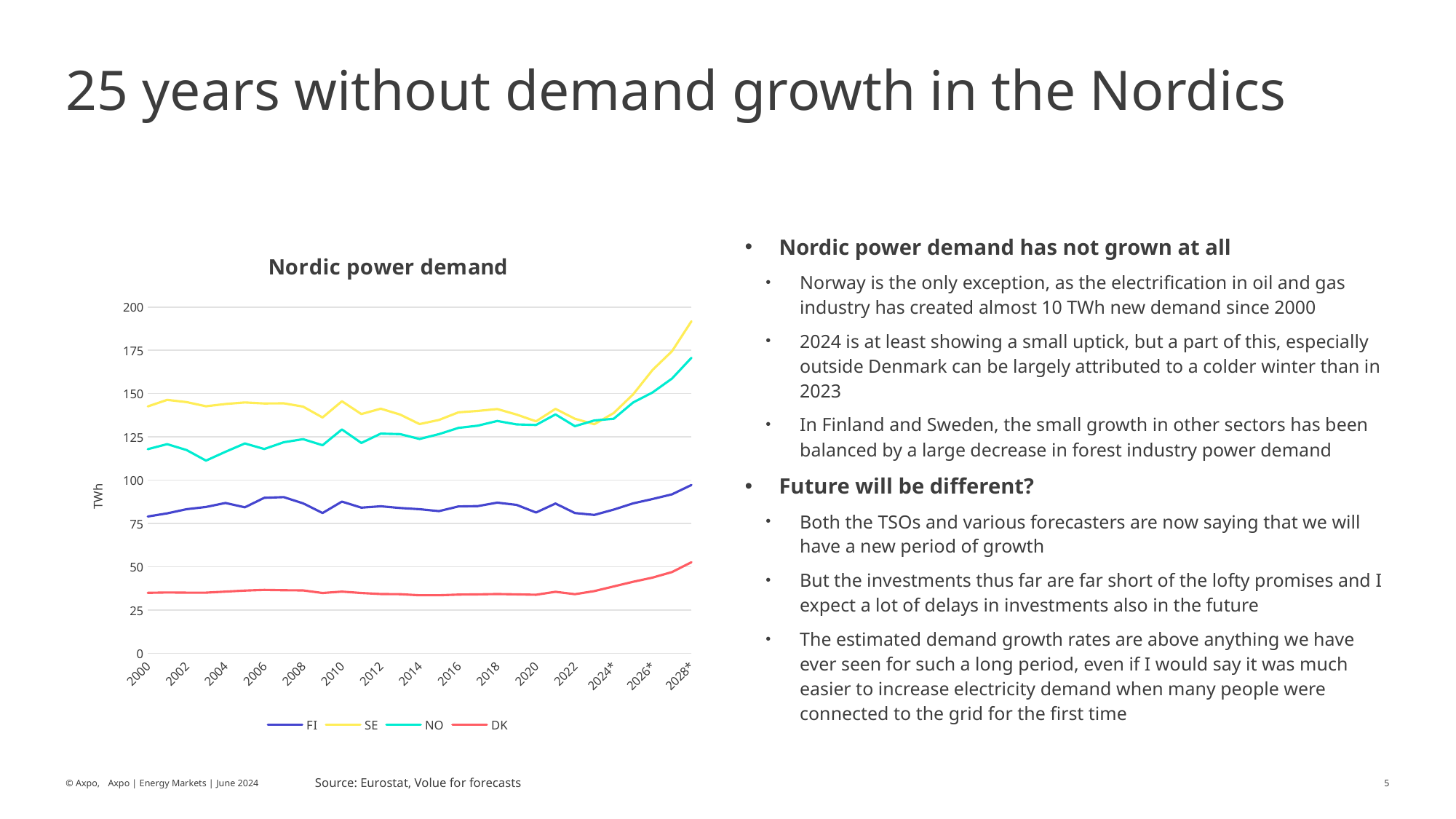
Which is larger in 2010, the value for SE or the value for FI? SE Does the DK series rise or fall between 2022 and 2028*? rise How many series does the legend of the Nordic power demand chart list? 4 Which series has the lowest values across the whole chart? DK Is the value for SE in 2028* greater or less than 175? greater Is the value for FI in 2000 greater or less than 100? less What kind of chart is shown on the slide? line chart Which series has the highest value in 2028*? SE What is the title of the chart? Nordic power demand What unit is shown on the y axis of the chart? TWh Is the value for DK in 2000 greater or less than 50? less